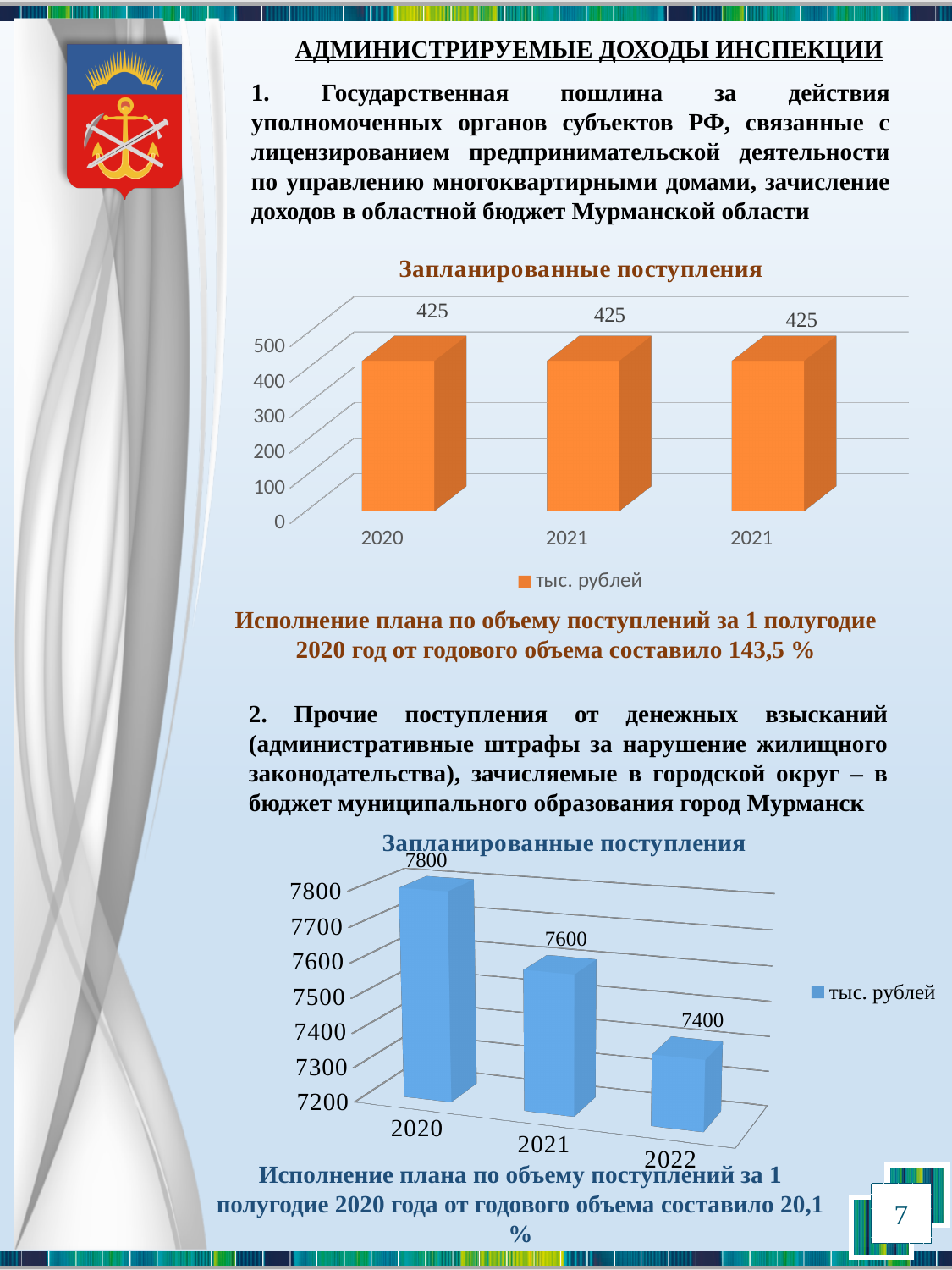
In the bottom chart, what is the value for 2021? 7600 In the top chart, is the value for 2020 greater or less than 400? greater In the bottom chart, which year has the highest value? 2020 What kind of chart is the bottom chart? bar chart In the bottom chart, do the values rise or fall from 2020 to 2022? fall In the bottom chart, what is the value for 2022? 7400 In the bottom chart, which year has the lowest value? 2022 In the bottom chart, which is larger, the value for 2020 or the value for 2021? 2020 In the top chart, what is the value for 2020? 425 In the bottom chart, what is the difference between the values for 2020 and 2022? 400 How many bars does the bottom chart show? 3 How many series does the legend of the top chart list? 1